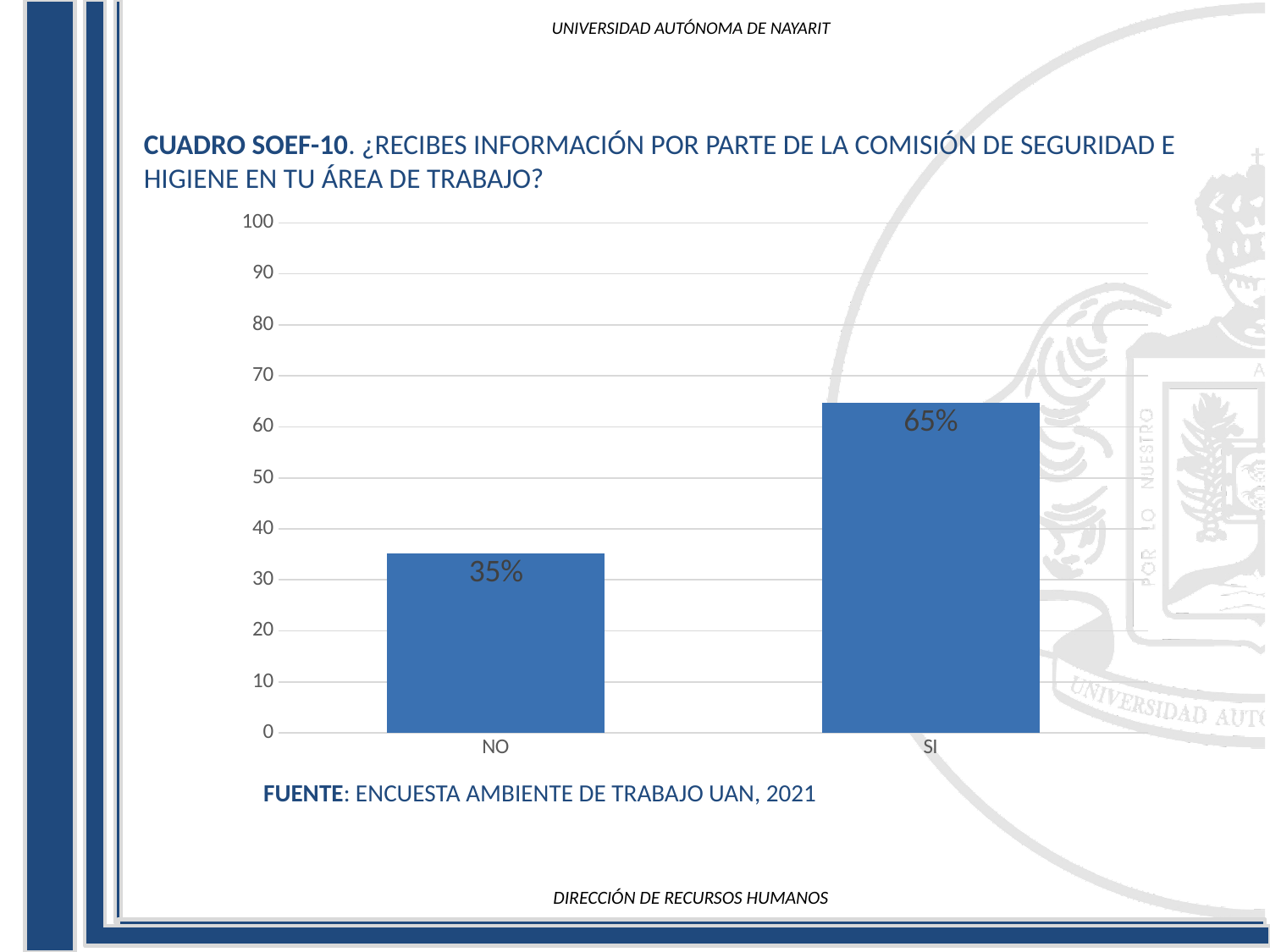
What is the value for SI? 65% Which is larger, the value for NO or the value for SI? SI What is the value for NO? 35% What is the difference between the values for SI and NO? 30% How many categories are shown on the x axis? 2 What source is cited below the chart? ENCUESTA AMBIENTE DE TRABAJO UAN, 2021 Is the value for SI greater or less than 60? greater Is the value for NO greater or less than 40? less Which category has the highest value? SI Which category has the lowest value? NO What is the maximum value shown on the y axis? 100 What kind of chart is shown on the slide? bar chart